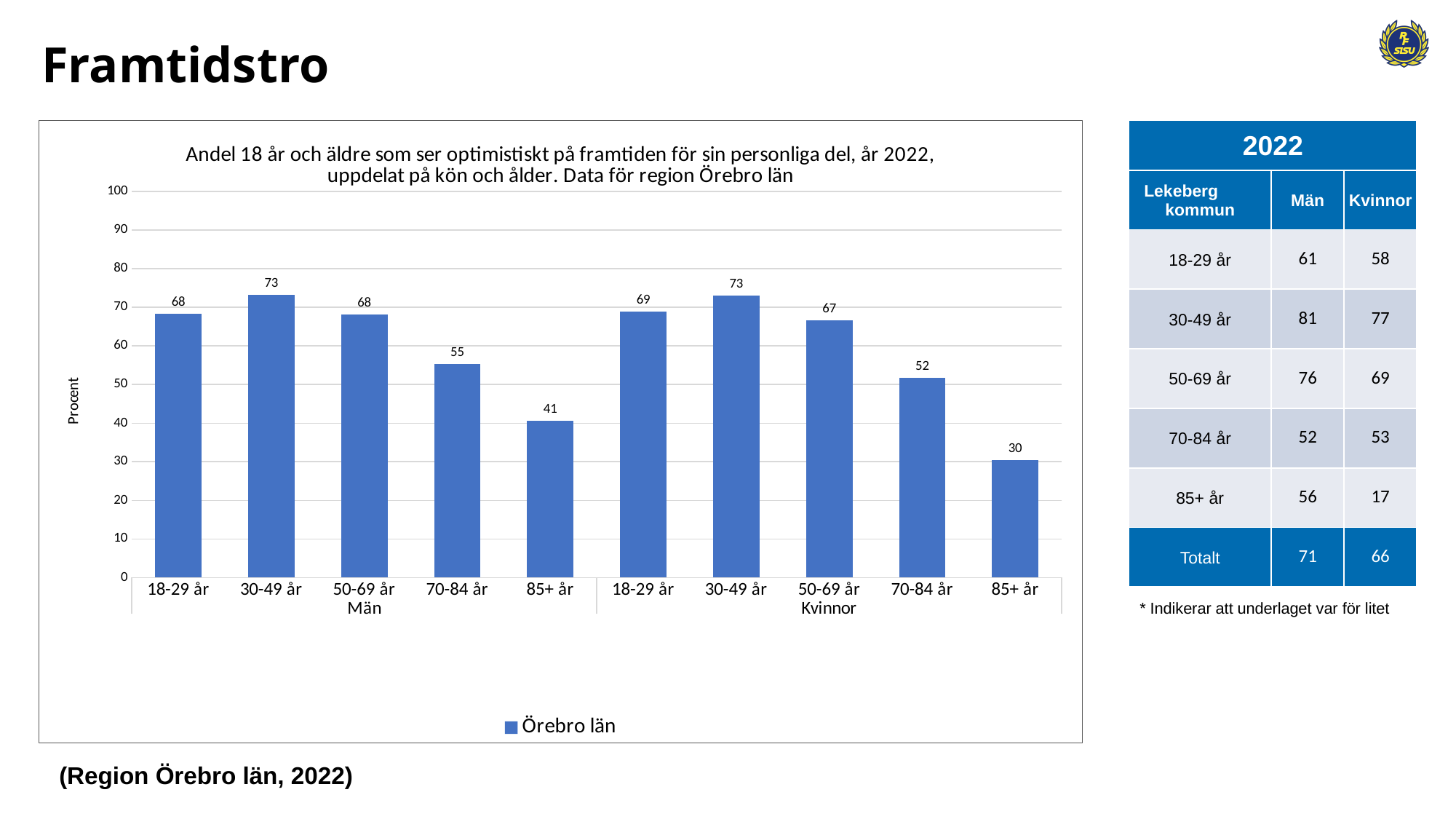
Which bar has the lowest value in the chart? 85+ år (Kvinnor) What type of chart is shown on the slide? bar chart What is the value for women (Kvinnor) aged 85+ år? 30 How many series does the legend list? 1 Do the values rise or fall across the age groups within the Kvinnor group from 30-49 år to 85+ år? fall Among the men (Män) age groups, which has the highest value? 30-49 år What is the value for men (Män) aged 85+ år? 41 Which is larger: the value for men aged 18-29 år or women aged 18-29 år? Kvinnor 18-29 år What is the value for men (Män) aged 30-49 år? 73 How many bars are plotted in the chart? 10 What is the difference between the values for men aged 85+ år and women aged 85+ år? 11 What is the value for women (Kvinnor) aged 70-84 år? 52